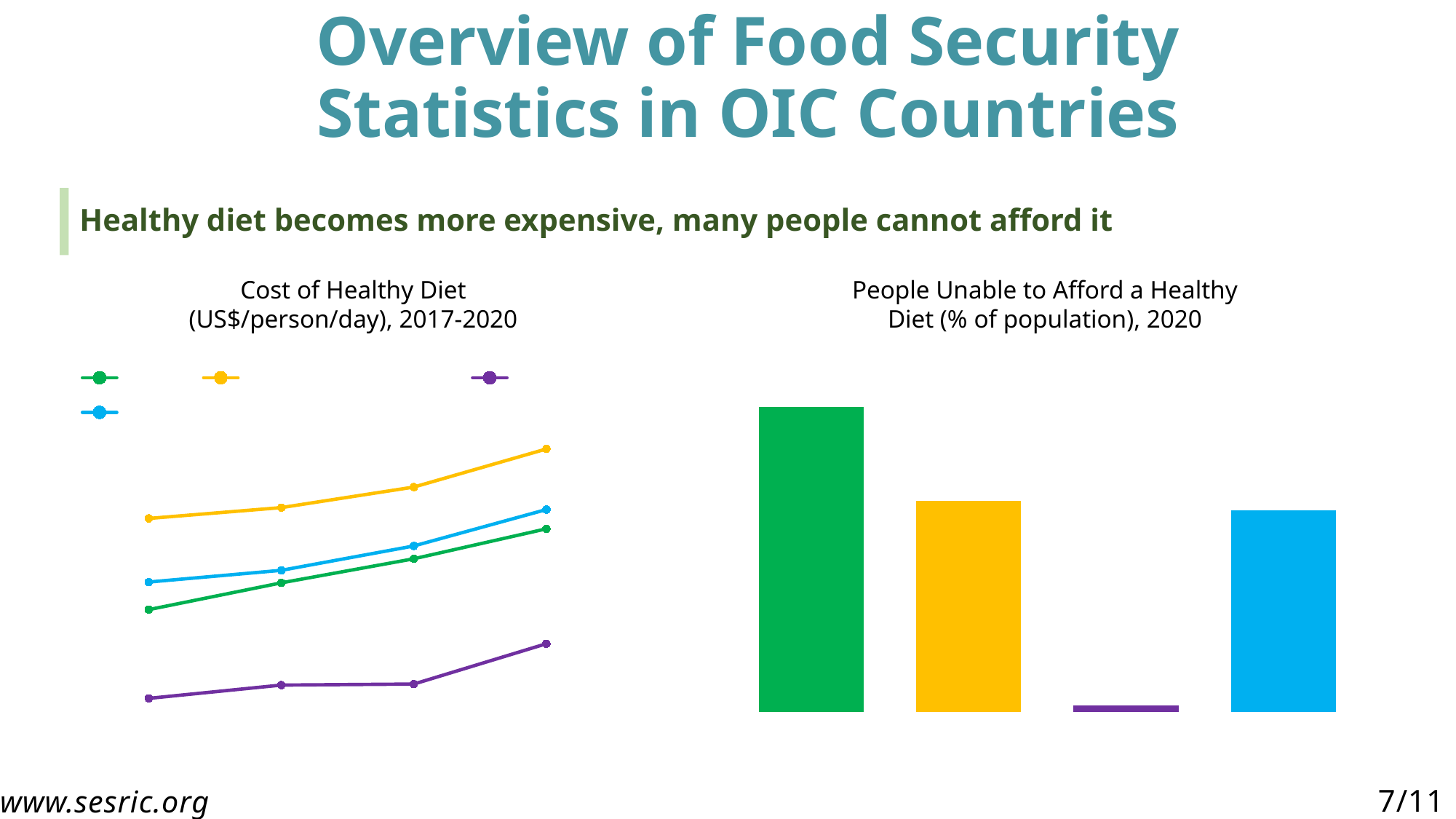
In the right chart, 'People Unable to Afford a Healthy Diet', how many bars are plotted? 4 In the left chart, 'Cost of Healthy Diet', do the lines generally rise or fall from 2017 to 2020? rise What kind of chart is the right chart, 'People Unable to Afford a Healthy Diet (% of population), 2020'? bar chart In the right chart, 'People Unable to Afford a Healthy Diet', which coloured bar is the tallest? the green bar In the left chart, 'Cost of Healthy Diet', which coloured line is the lowest across all years? the purple line What is the title of the chart on the right side of the slide? People Unable to Afford a Healthy Diet (% of population), 2020 What kind of chart is the left chart, 'Cost of Healthy Diet (US$/person/day), 2017-2020'? line chart In the left chart, 'Cost of Healthy Diet', which coloured line is the highest across all years? the yellow line In the right chart, 'People Unable to Afford a Healthy Diet', which coloured bar is the shortest? the purple bar In the right chart, 'People Unable to Afford a Healthy Diet', which is taller, the green bar or the yellow bar? the green bar In the left chart, 'Cost of Healthy Diet', how many data points does each line have? 4 In the left chart, 'Cost of Healthy Diet', how many series does the legend list? 4